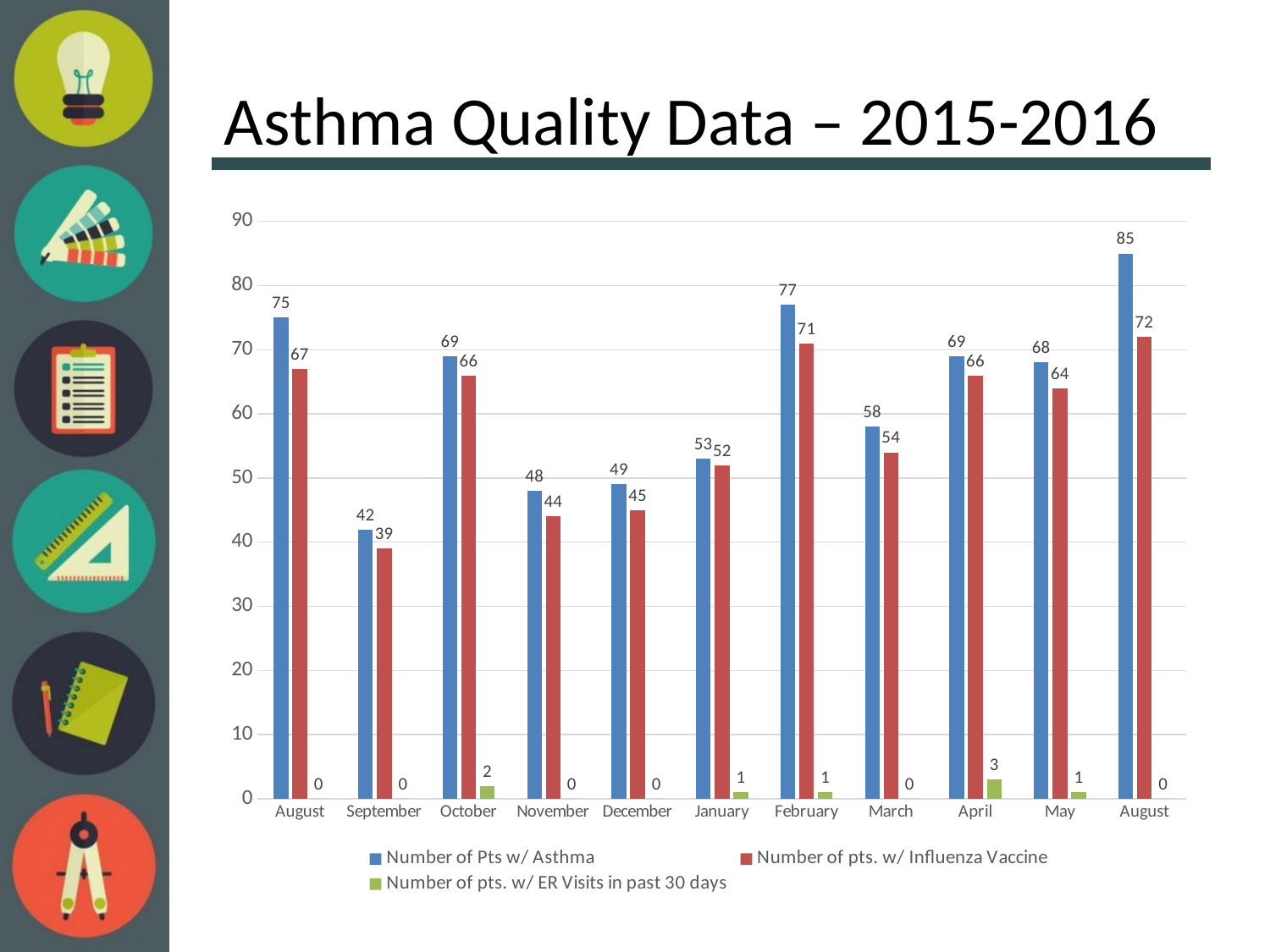
Which is larger in October: the Number of Pts w/ Asthma or the Number of pts. w/ Influenza Vaccine? Number of Pts w/ Asthma What is the Number of pts. w/ ER Visits in past 30 days for April? 3 What is the difference between the Number of Pts w/ Asthma and the Number of pts. w/ Influenza Vaccine in March? 4 How many categories are shown on the x axis? 11 Which category has the lowest Number of pts. w/ Influenza Vaccine? September Which category has the highest Number of Pts w/ Asthma? August (the last category) What is the title of the chart on the slide? Asthma Quality Data – 2015-2016 What kind of chart is shown on the slide? bar chart How many series does the legend list? 3 What is the Number of Pts w/ Asthma for February? 77 What is the Number of pts. w/ Influenza Vaccine for September? 39 Is the Number of Pts w/ Asthma for November greater or less than 50? less